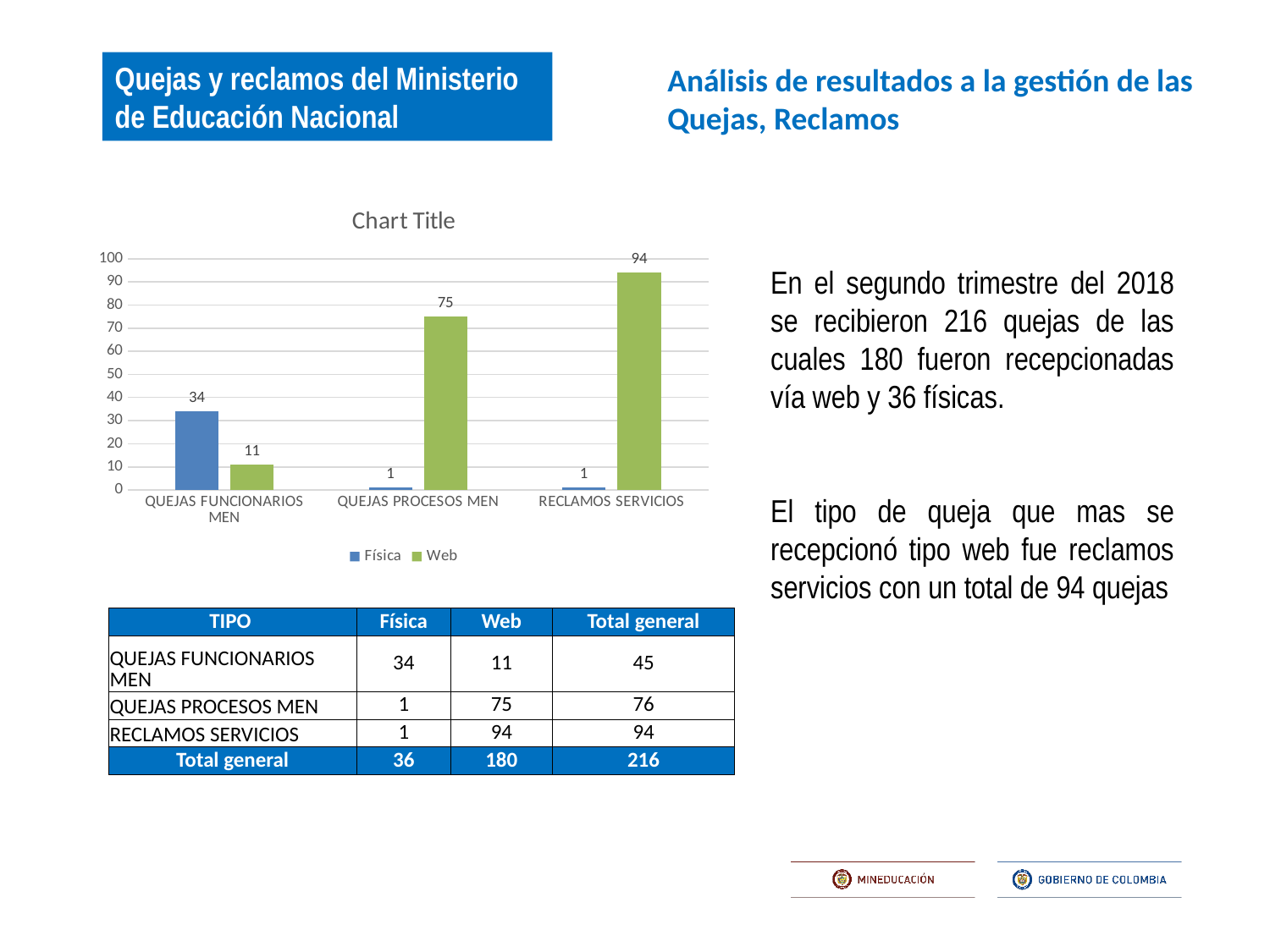
What is the difference between the Web values for RECLAMOS SERVICIOS and QUEJAS PROCESOS MEN? 19 What kind of chart is shown? bar chart Which category has the lowest Web value? QUEJAS FUNCIONARIOS MEN Which is larger for QUEJAS FUNCIONARIOS MEN, the Física value or the Web value? Física What is the Física value for QUEJAS PROCESOS MEN? 1 How many categories are shown on the x axis? 3 What are the two series named in the legend? Física and Web What is the Web value for RECLAMOS SERVICIOS? 94 What is the Física value for QUEJAS FUNCIONARIOS MEN? 34 How many series does the legend list? 2 What is the Web value for QUEJAS PROCESOS MEN? 75 Which category has the highest Web value? RECLAMOS SERVICIOS